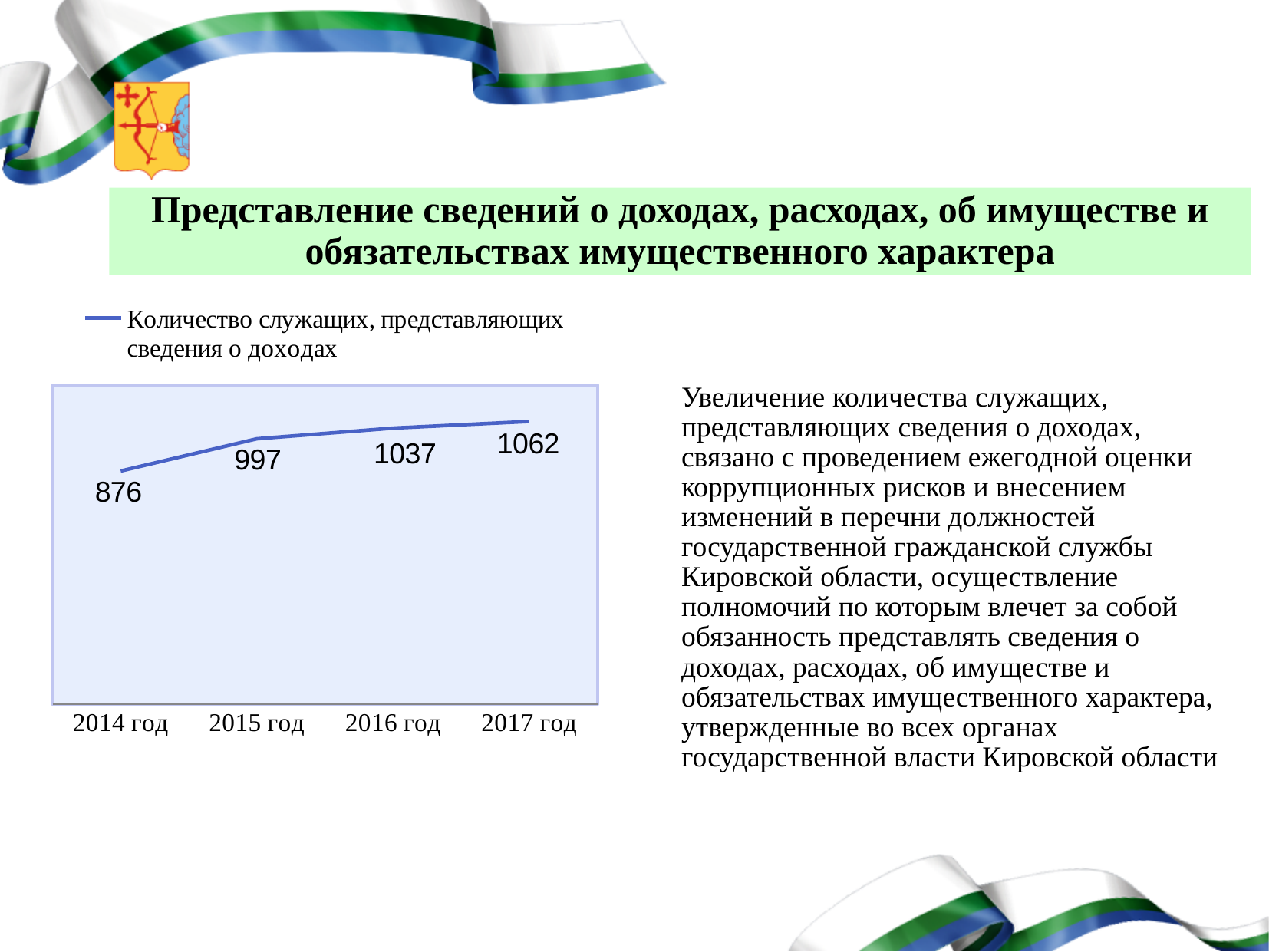
What kind of chart is shown? line chart Which year has the lowest value? 2014 год What is the difference between the values for 2015 год and 2014 год? 121 What is the difference between the values for 2017 год and 2014 год? 186 Do the values rise or fall from 2014 год to 2017 год? rise What is the value for 2017 год? 1062 What is the value for 2016 год? 1037 What is the value for 2014 год? 876 Which year has the highest value? 2017 год Which is larger, the value for 2016 год or the value for 2015 год? 2016 год What is the value for 2015 год? 997 How many years are plotted on the chart? 4